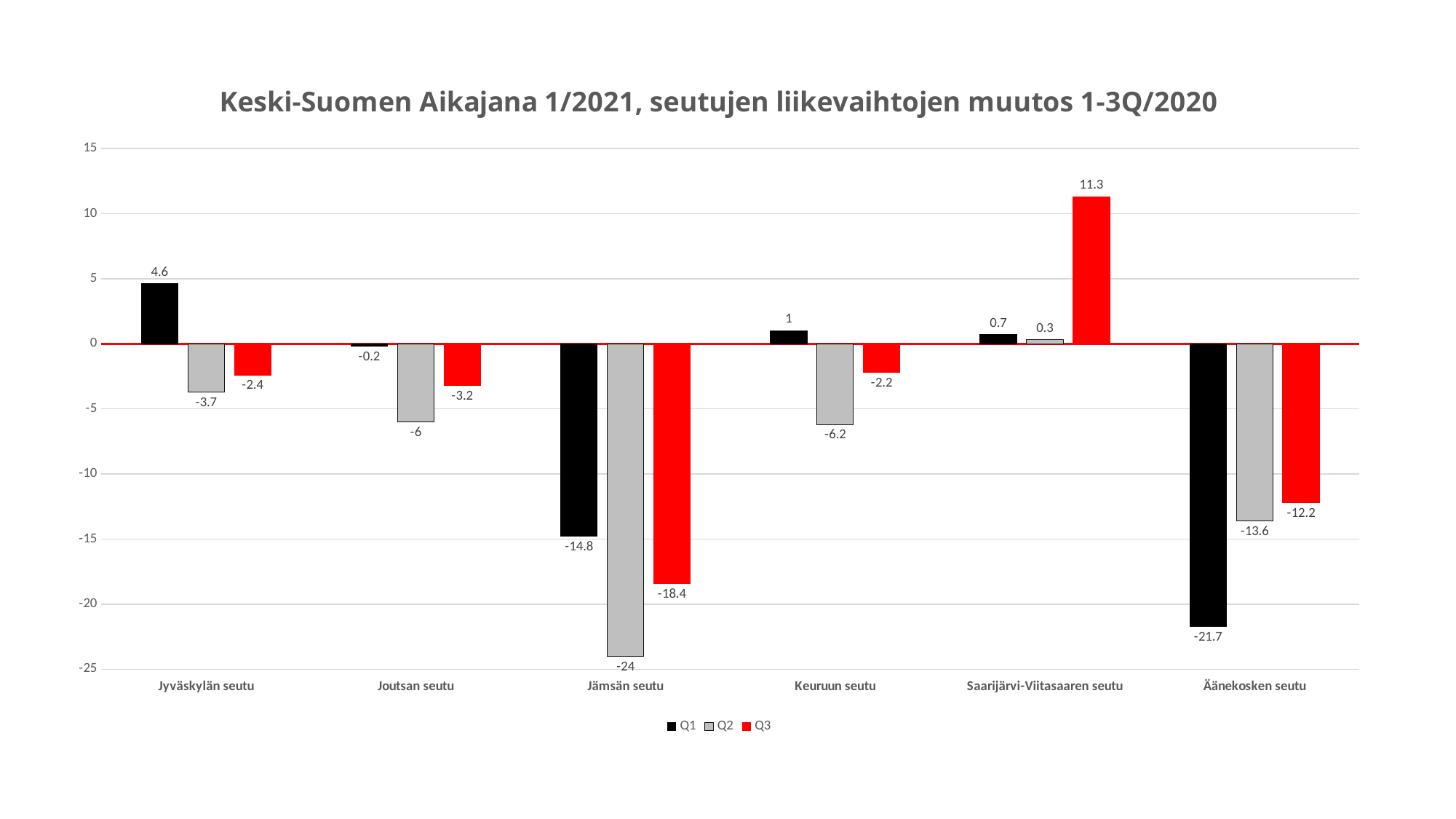
Which region has the highest Q3 value? Saarijärvi-Viitasaaren seutu Which colour represents the Q3 series in the legend? Red What is the Q3 value for Saarijärvi-Viitasaaren seutu? 11.3 How many series does the legend list? 3 What kind of chart is shown on the slide? Bar chart What is the Q1 value for Jyväskylän seutu? 4.6 What is the Q1 value for Äänekosken seutu? -21.7 What is the difference between the Q3 values for Jämsän seutu and Äänekosken seutu? 6.2 Which region has the lowest Q2 value? Jämsän seutu What is the Q2 value for Jämsän seutu? -24 How many regions are shown on the x axis? 6 Which is larger, the Q2 value for Joutsan seutu or the Q2 value for Keuruun seutu? Joutsan seutu